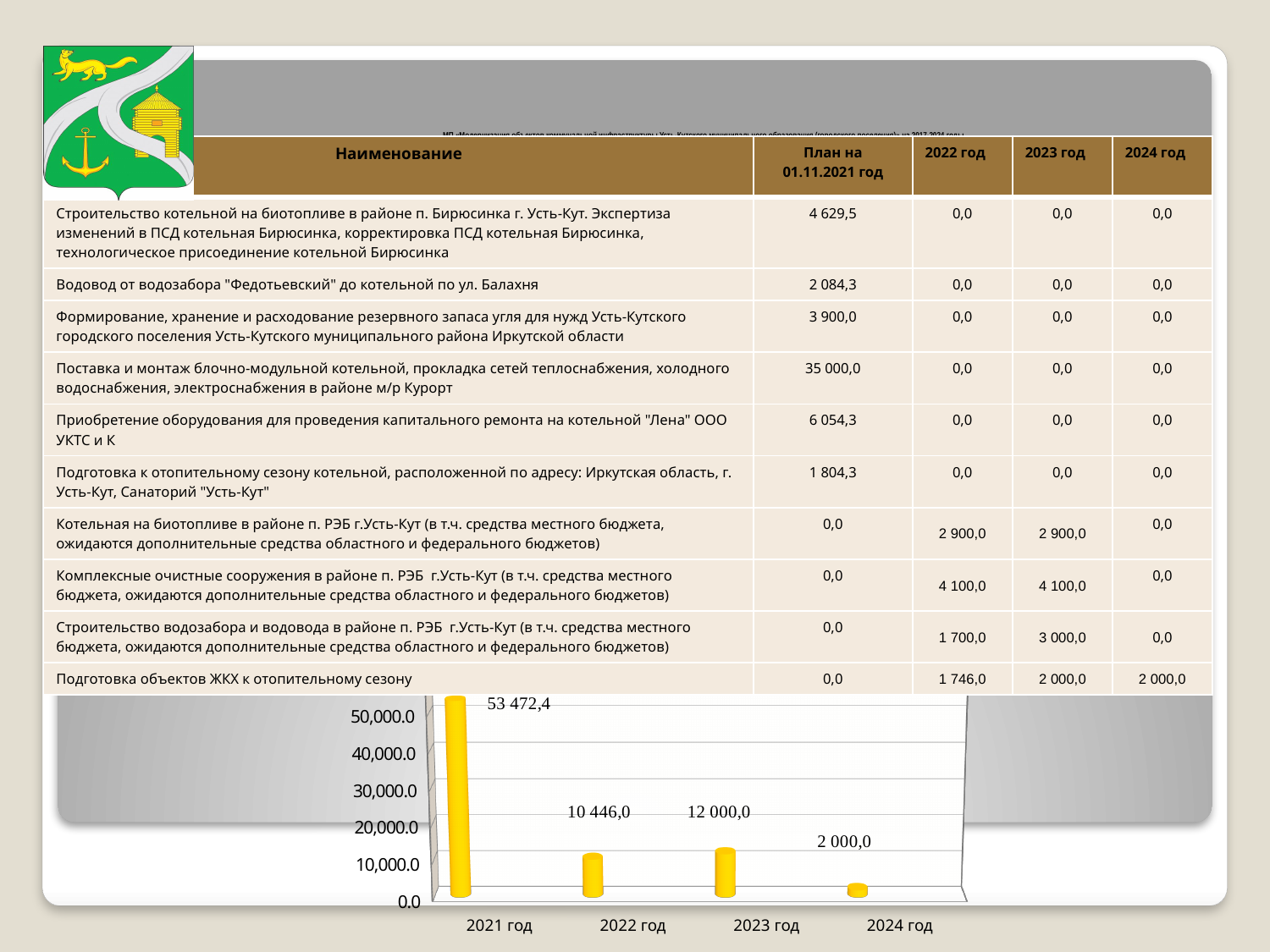
In the bar chart, what is the value for 2023 год? 12 000,0 In the bar chart, what is the value for 2022 год? 10 446,0 How many categories (years) are shown on the x axis of the bar chart? 4 In the bar chart, which is larger: the value for 2022 год or 2023 год? 2023 год In the bar chart, which year has the highest value? 2021 год In the bar chart, does the value rise or fall from 2023 год to 2024 год? fall In the bar chart, what is the value for 2024 год? 2 000,0 In the bar chart, is the value for 2021 год greater or less than 50,000.0? greater In the bar chart, what is the difference between the values for 2023 год and 2022 год? 1 554,0 In the bar chart, which year has the lowest value? 2024 год What type of chart is shown at the bottom of the slide? bar chart In the bar chart, what is the value for 2021 год? 53 472,4